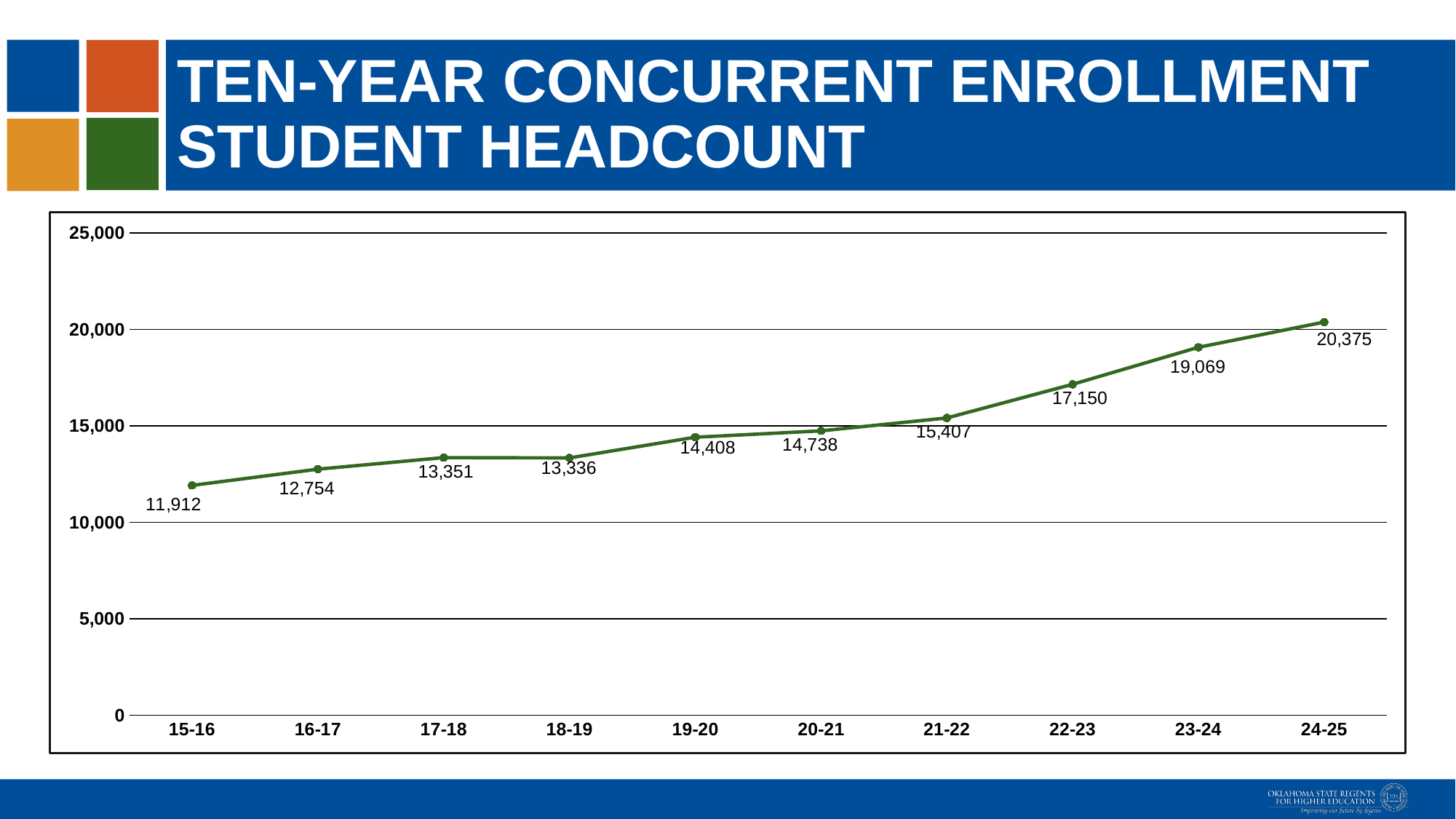
What kind of chart is shown on the slide? line chart Does the headcount generally rise or fall from 15-16 to 24-25? rise What is the difference in headcount between 24-25 and 15-16? 8,463 Which year has the lowest concurrent enrollment student headcount? 15-16 Which year has a larger headcount, 17-18 or 18-19? 17-18 What is the difference in headcount between 22-23 and 21-22? 1,743 What is the headcount value shown for 19-20? 14,408 Which year has the highest concurrent enrollment student headcount? 24-25 What is the concurrent enrollment student headcount for 15-16? 11,912 What is the concurrent enrollment student headcount for 24-25? 20,375 Is the headcount for 23-24 greater or less than 20,000? less How many academic years are plotted on the chart? 10